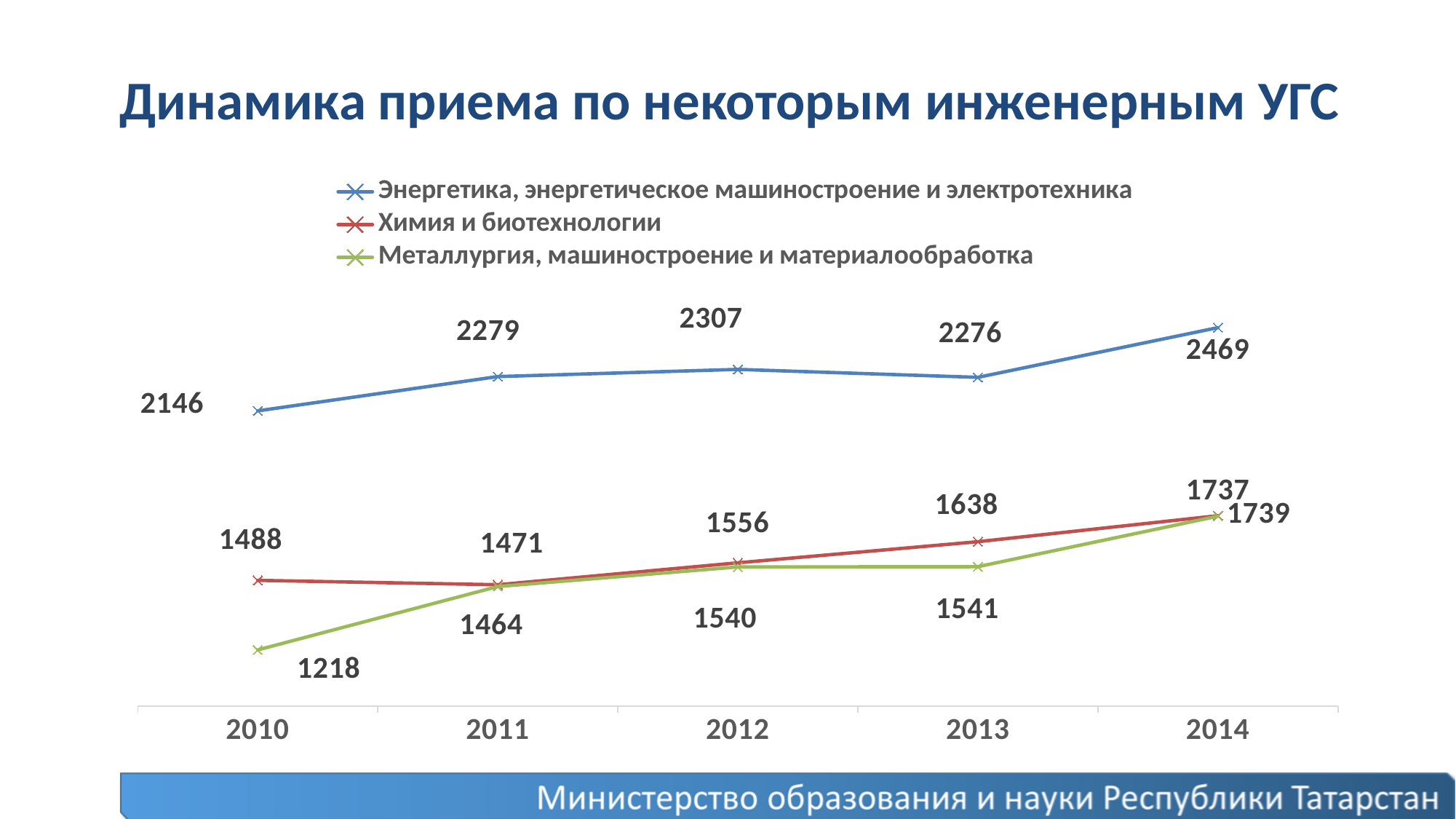
What is the value for Химия и биотехнологии in 2013? 1638 In which year is the value for Энергетика, энергетическое машиностроение и электротехника highest? 2014 In which year is the value for Металлургия, машиностроение и материалообработка lowest? 2010 Which series has the larger value in 2012: Химия и биотехнологии or Металлургия, машиностроение и материалообработка? Химия и биотехнологии What kind of chart is shown on the slide? line chart Does the value for Металлургия, машиностроение и материалообработка rise or fall from 2010 to 2014? rise What is the difference between the 2014 and 2010 values for Энергетика, энергетическое машиностроение и электротехника? 323 What is the title of the chart? Динамика приема по некоторым инженерным УГС How many years are shown on the x axis? 5 How many series does the legend list? 3 What is the value for Металлургия, машиностроение и материалообработка in 2011? 1464 What is the value for Энергетика, энергетическое машиностроение и электротехника in 2010? 2146